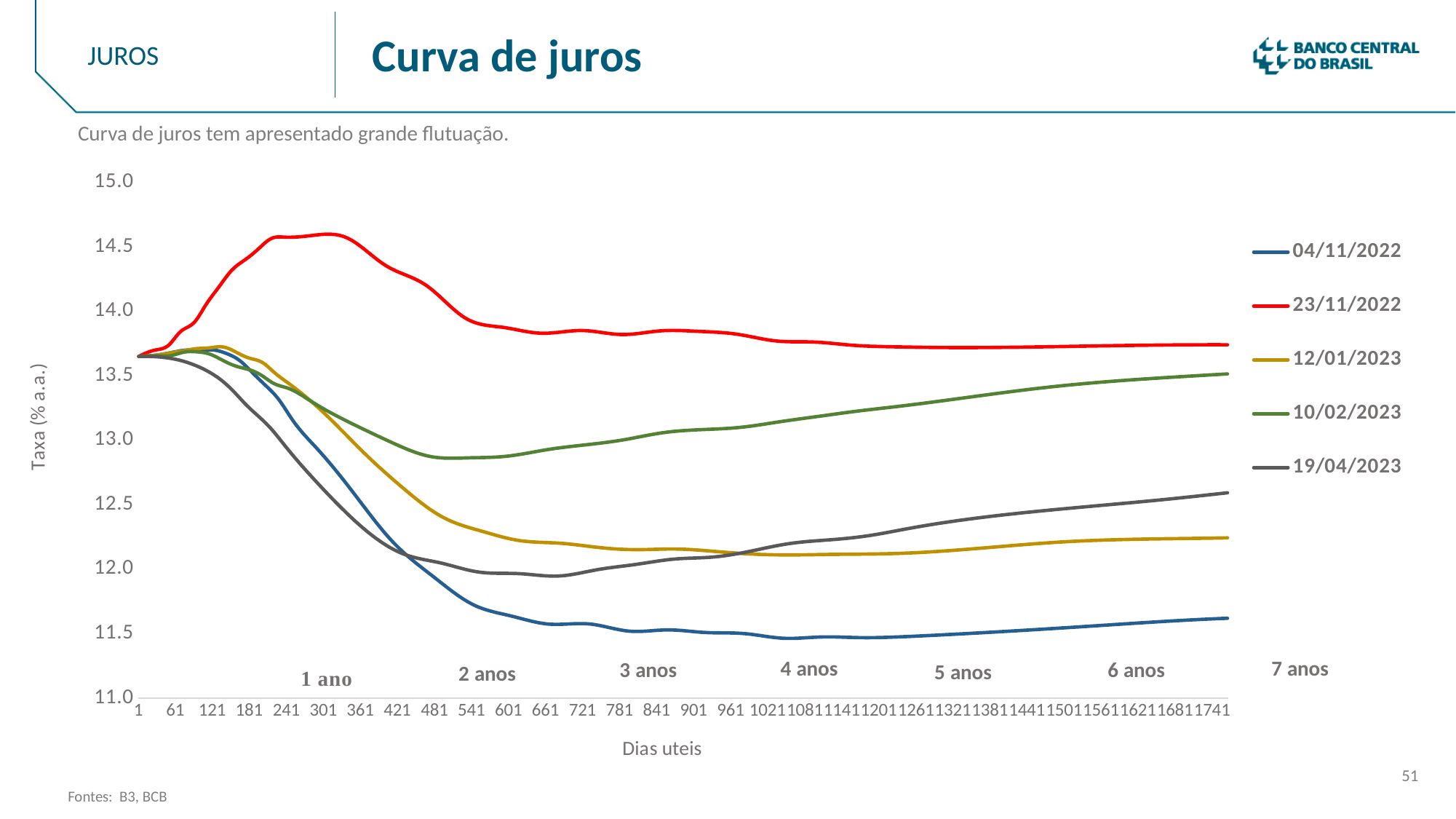
Which series has the highest value at the right end of the chart (day 1741)? 23/11/2022 What kind of chart is shown on the slide? line chart Is the value for 04/11/2022 at day 1021 greater or less than 12.0? less What is the title of the vertical axis? Taxa (% a.a.) Is the value for 23/11/2022 at day 301 greater or less than 14.0? greater Is the value for 10/02/2023 at day 1741 greater or less than 13.0? greater Which series reaches the highest peak anywhere on the chart? 23/11/2022 How many series does the legend list? 5 At day 1741, which series is higher: 19/04/2023 or 12/01/2023? 19/04/2023 Does the 23/11/2022 series rise or fall between day 1 and day 301? rises Which series has the lowest value at the right end of the chart (day 1741)? 04/11/2022